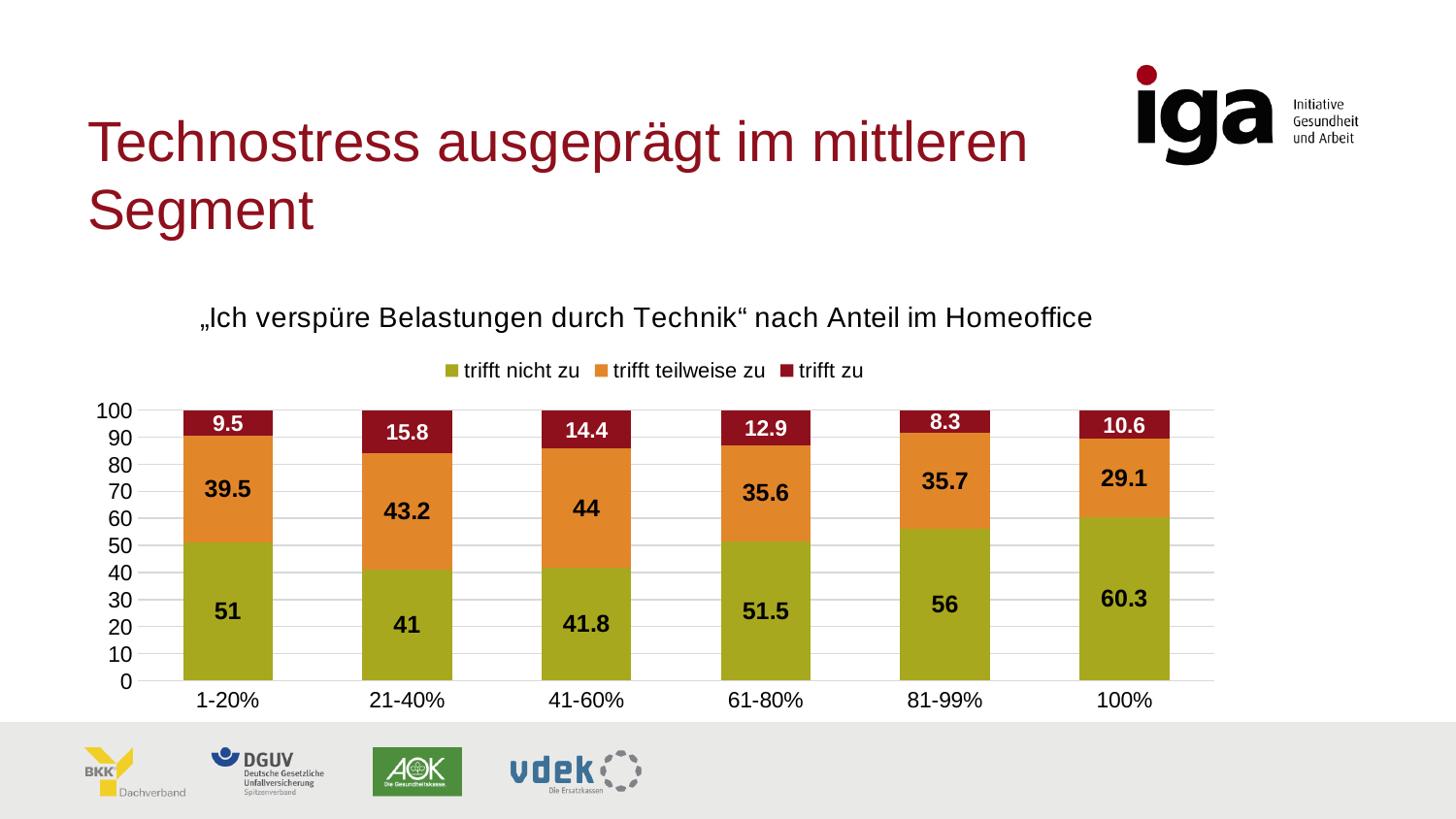
How many categories are shown on the x axis? 6 What is the value of "trifft nicht zu" for the 100% category? 60.3 Which category has the highest value for "trifft zu"? 21-40% What type of chart is shown on the slide? stacked bar chart Which is larger: "trifft teilweise zu" for 41-60% or for 81-99%? 41-60% Which series is shown in red in the legend? trifft zu What is the total of the stacked bar for the 41-60% category? 100.2 What is the value of "trifft teilweise zu" for the 61-80% category? 35.6 What is the difference between the "trifft nicht zu" values for 100% and 1-20%? 9.3 Which category has the lowest value for "trifft nicht zu"? 21-40% What is the value of "trifft zu" for the 21-40% category? 15.8 How many series does the legend list? 3